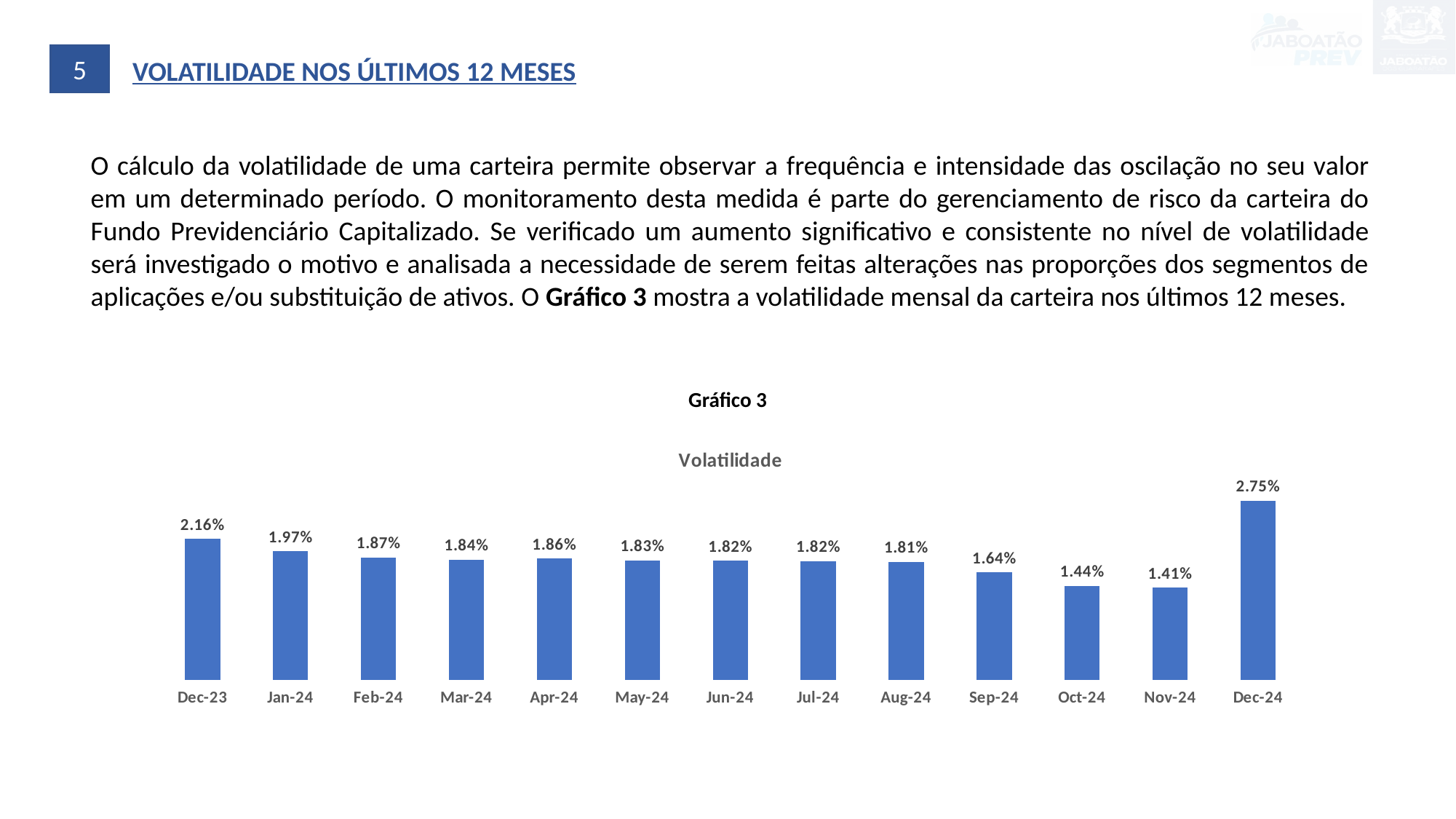
Which is larger, the volatility in Oct-24 or in Sep-24? Sep-24 What is the difference between the volatility in Dec-23 and Jan-24? 0.19% How many months are shown in the chart? 13 Which month has the lowest volatility? Nov-24 Which month has the highest volatility? Dec-24 What kind of chart is shown? Bar chart What is the volatility value for Dec-24? 2.75% What is the volatility value for Sep-24? 1.64% What is the difference between the volatility in Dec-24 and Nov-24? 1.34% What is the title of the chart? Volatilidade What is the volatility value for Dec-23? 2.16% Does the volatility rise or fall from Dec-23 to Nov-24? Fall